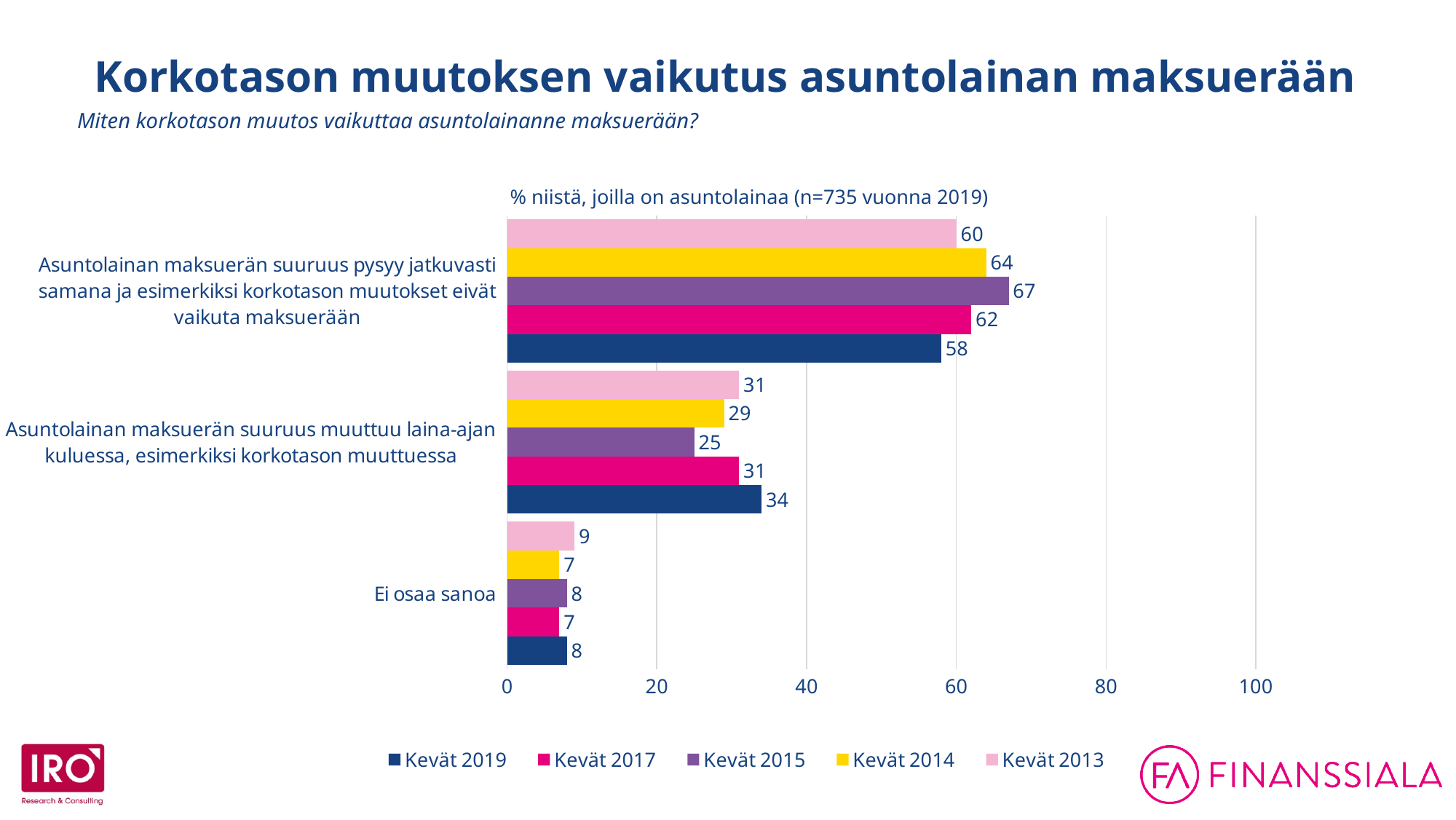
What type of chart is shown on the slide? Bar chart For 'Asuntolainan maksuerän suuruus muuttuu laina-ajan kuluessa, esimerkiksi korkotason muuttuessa', which is larger: the Kevät 2019 value or the Kevät 2014 value? Kevät 2019 Which series has the lowest value for 'Asuntolainan maksuerän suuruus muuttuu laina-ajan kuluessa, esimerkiksi korkotason muuttuessa'? Kevät 2015 How many series does the legend list? 5 What is the Kevät 2015 value for 'Asuntolainan maksuerän suuruus muuttuu laina-ajan kuluessa, esimerkiksi korkotason muuttuessa'? 25 Which series has the highest value for 'Asuntolainan maksuerän suuruus pysyy jatkuvasti samana ja esimerkiksi korkotason muutokset eivät vaikuta maksuerään'? Kevät 2015 What is the Kevät 2013 value for 'Ei osaa sanoa'? 9 What is the difference between the Kevät 2015 and Kevät 2019 values for 'Asuntolainan maksuerän suuruus pysyy jatkuvasti samana ja esimerkiksi korkotason muutokset eivät vaikuta maksuerään'? 9 How many categories are shown on the chart? 3 What is the title of the chart? Korkotason muutoksen vaikutus asuntolainan maksuerään What is the Kevät 2019 value for 'Asuntolainan maksuerän suuruus pysyy jatkuvasti samana ja esimerkiksi korkotason muutokset eivät vaikuta maksuerään'? 58 Is the Kevät 2014 value for 'Asuntolainan maksuerän suuruus pysyy jatkuvasti samana ja esimerkiksi korkotason muutokset eivät vaikuta maksuerään' greater or less than 60? greater